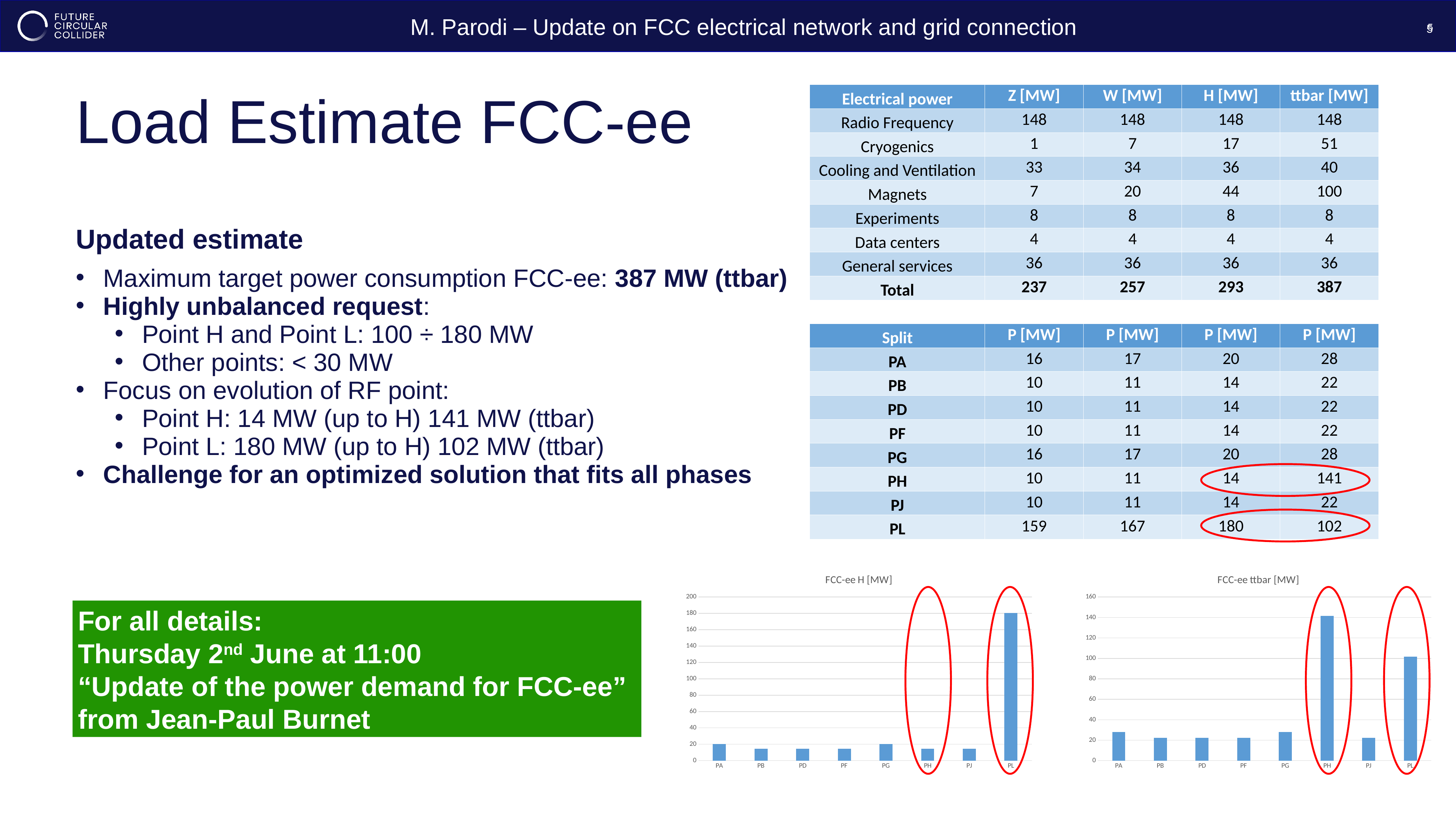
What kind of chart is the "FCC-ee H [MW]" chart? bar chart In the "FCC-ee H [MW]" chart, which category has the highest value? PL How many categories are shown on the x axis of the "FCC-ee ttbar [MW]" chart? 8 In the "FCC-ee ttbar [MW]" chart, is the value for PH greater or less than 120? greater In the "FCC-ee H [MW]" chart, is the value for PA greater or less than 40? less In the "FCC-ee ttbar [MW]" chart, is the value for PL greater or less than 80? greater In the "FCC-ee ttbar [MW]" chart, which category has the highest value? PH In the "FCC-ee H [MW]" chart, what is the value for PL? 180 In the "FCC-ee ttbar [MW]" chart, which is larger, the value for PH or the value for PL? PH In the "FCC-ee H [MW]" chart, which is larger, the value for PL or the value for PG? PL What is the highest value shown on the y axis of the "FCC-ee ttbar [MW]" chart? 160 What is the title of the bar chart on the left of the two charts at the bottom of the slide? FCC-ee H [MW]